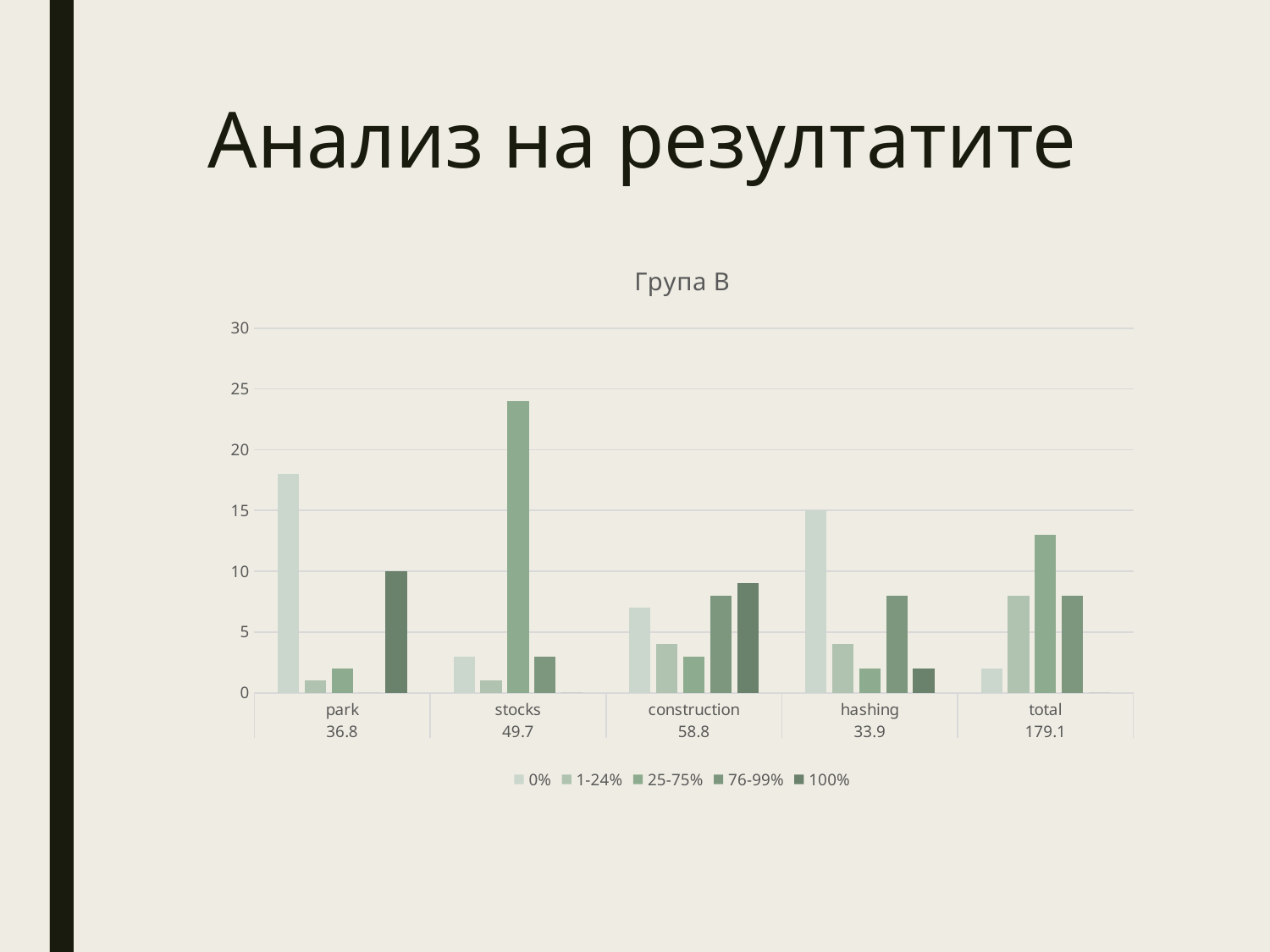
Which series has the highest value in the stocks category? 25-75% Which is larger: the 0% series value for park or the 0% series value for hashing? park What kind of chart is shown on the slide? bar chart What is the title of the chart? Група B Is the value of the 100% series for hashing greater or less than 5? less What is the value of the 0% series for the hashing category? 15 How many series does the chart's legend list? 5 What number is printed beneath the 'total' category label? 179.1 Is the value of the 25-75% series for stocks greater or less than 20? greater Which category has the tallest bar in the whole chart? stocks How many categories are shown along the x axis of the chart? 5 What is the value of the 100% series for the park category? 10